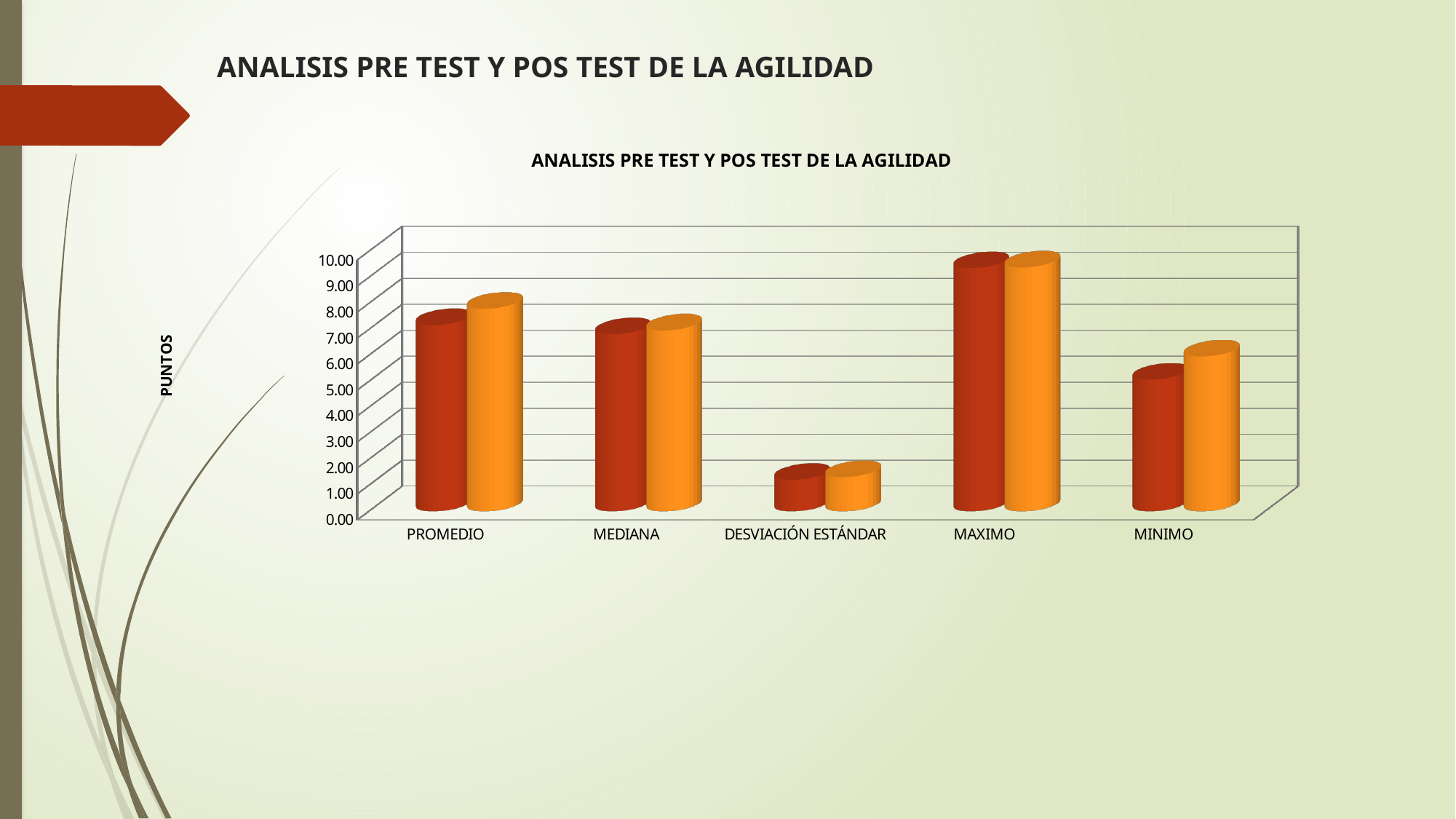
What is the title of the chart? ANALISIS PRE TEST Y POS TEST DE LA AGILIDAD Is the value of the orange bar for MINIMO greater or less than 5.00? greater What kind of chart is shown on the slide? bar chart Which category has the highest bars in the chart? MAXIMO What is the label on the vertical axis of the chart? PUNTOS For MINIMO, which bar is taller, the red bar or the orange bar? the orange bar Which category has the lowest bars in the chart? DESVIACIÓN ESTÁNDAR Is the value of the red bar for DESVIACIÓN ESTÁNDAR greater or less than 2.00? less Is the value of the orange bar for MAXIMO greater or less than 8.00? greater How many categories are shown on the x axis of the chart? 5 Which is larger, the red bar for PROMEDIO or the red bar for MINIMO? the red bar for PROMEDIO